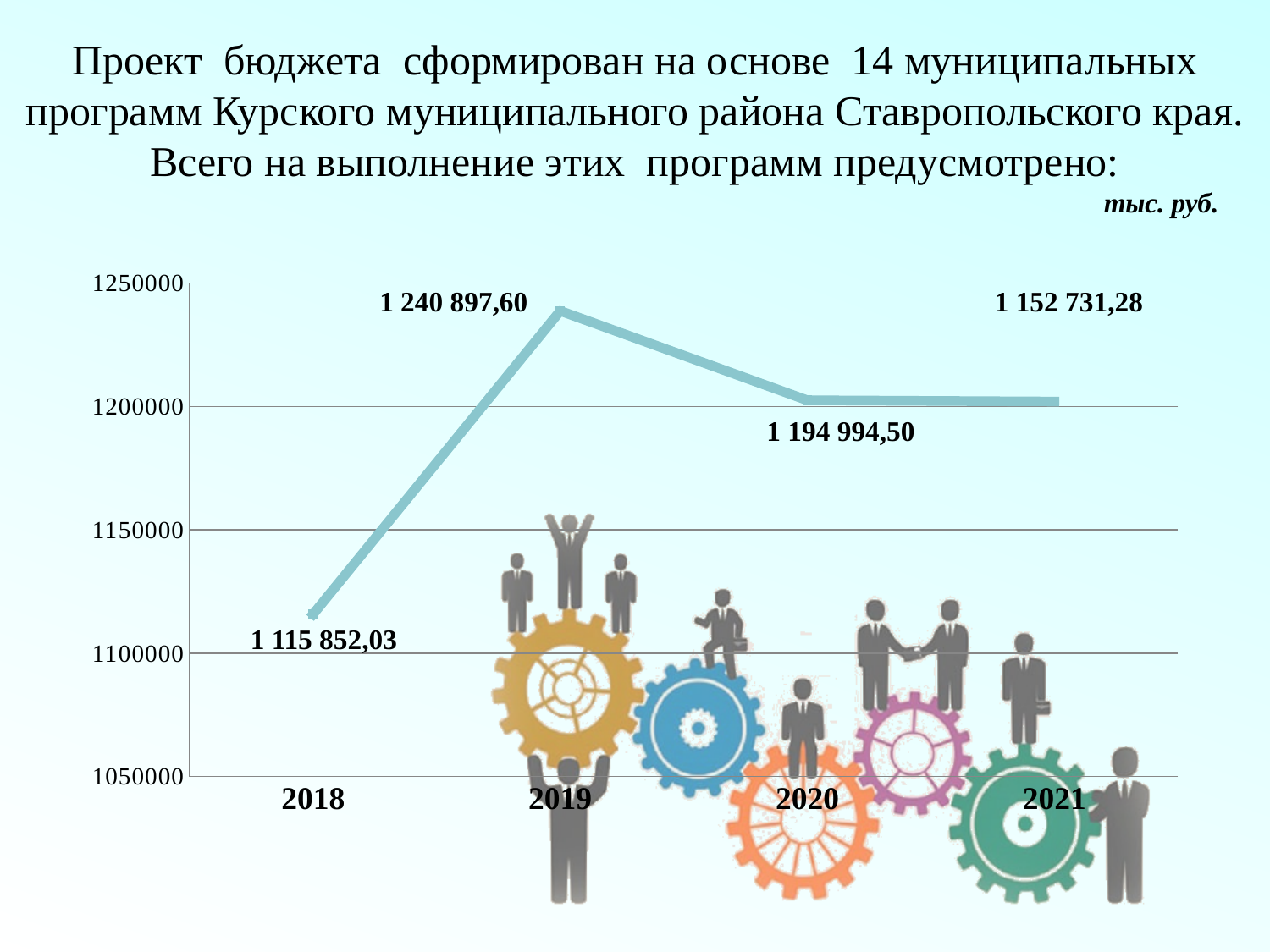
What is the difference between the values for 2019 and 2020? 45 903,10 Which is larger, the value for 2018 or the value for 2020? 2020 What kind of chart is shown on the slide? line chart What is the difference between the values for 2019 and 2018? 125 045,57 Is the value for 2018 greater or less than 1150000? less What is the value for 2019? 1 240 897,60 What is the value labelled for 2021? 1 152 731,28 What is the value for 2018? 1 115 852,03 Which year has the lowest value? 2018 What is the value for 2020? 1 194 994,50 How many years are plotted on the chart? 4 Which year has the highest value? 2019